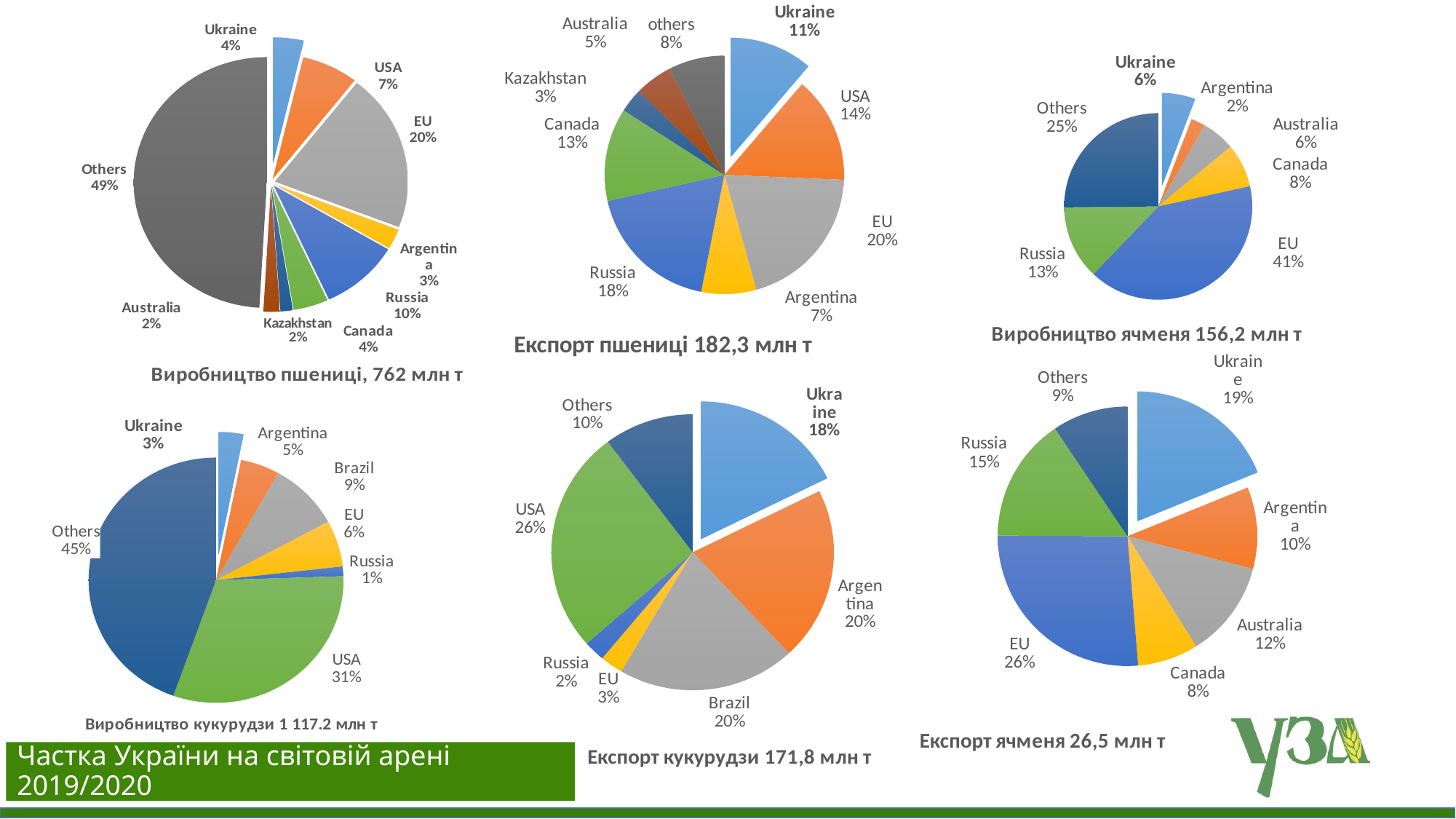
How many slices does the chart titled "Виробництво пшениці, 762 млн т" have? 9 How many pie charts are shown on the slide? 6 In the chart titled "Виробництво кукурудзи 1 117.2 млн т", which category has the smallest share? Russia In the chart titled "Експорт кукурудзи 171,8 млн т", what share does Brazil have? 20% In the chart titled "Експорт ячменя 26,5 млн т", what is the difference between the EU share and the Ukraine share? 7% What kind of chart is the chart titled "Експорт ячменя 26,5 млн т"? Pie chart In the chart titled "Виробництво пшениці, 762 млн т", what share does Others have? 49% In the chart titled "Експорт кукурудзи 171,8 млн т", which category has the largest share? USA In the chart titled "Експорт пшениці 182,3 млн т", what share does Ukraine have? 11% In the chart titled "Експорт пшениці 182,3 млн т", which is larger, the share for Russia or the share for USA? Russia In the chart titled "Виробництво ячменя 156,2 млн т", what share does the EU have? 41% In the chart titled "Виробництво ячменя 156,2 млн т", what is the combined share of Canada and Australia? 14%